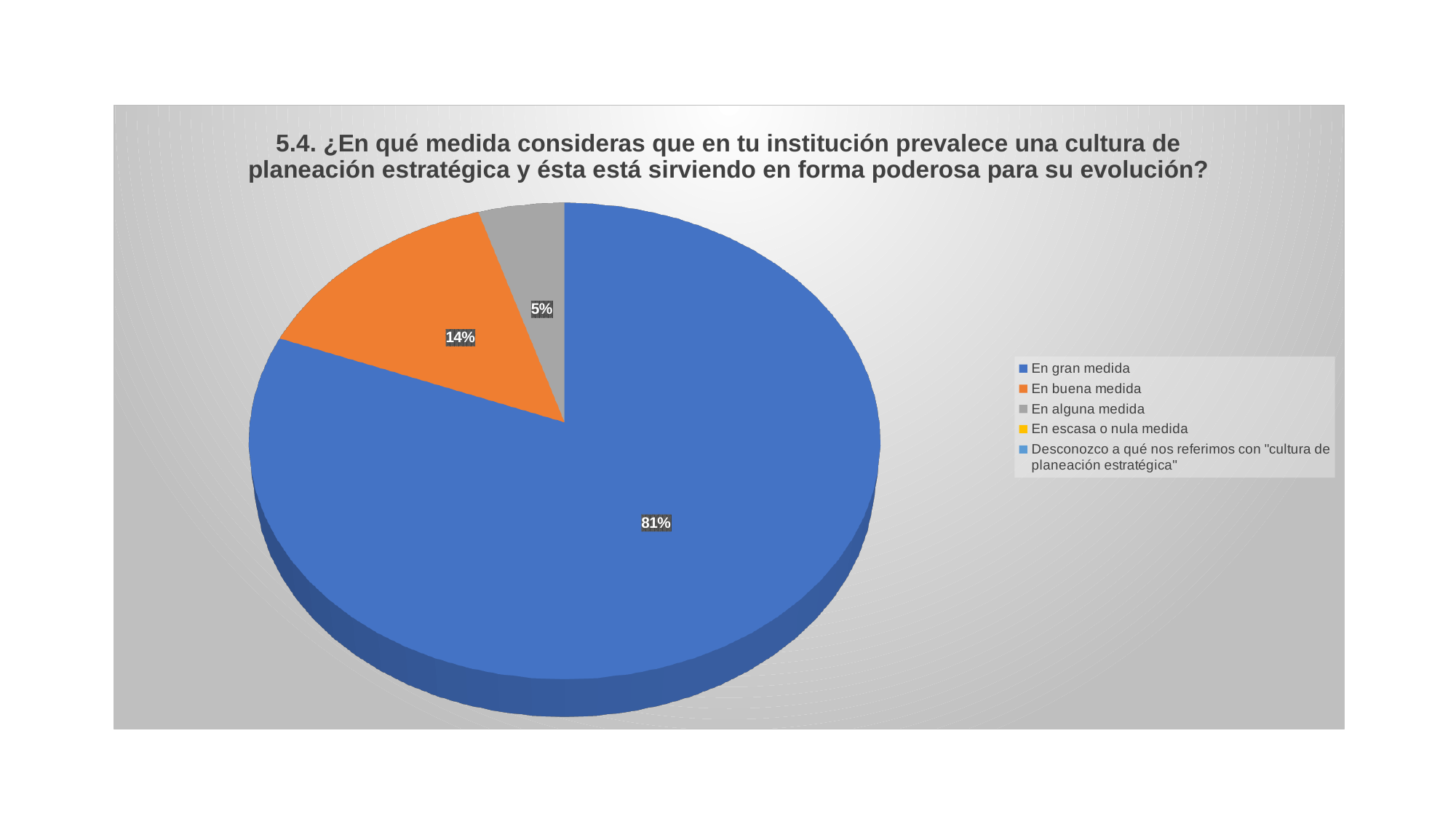
Which is larger, the share for "En buena medida" or the share for "En alguna medida"? En buena medida What is the difference in percentage points between "En gran medida" and "En buena medida"? 67 Is the share for "En gran medida" greater or less than 50%? greater What colour is the slice for "En buena medida"? Orange Which of the labelled slices is the smallest? En alguna medida What percentage of respondents answered "En buena medida"? 14% What is the combined share of "En buena medida" and "En alguna medida"? 19% What percentage of respondents answered "En gran medida"? 81% Which response category has the largest share of the pie? En gran medida What type of chart is shown on the slide? Pie chart What percentage of respondents answered "En alguna medida"? 5% How many entries does the legend list? 5